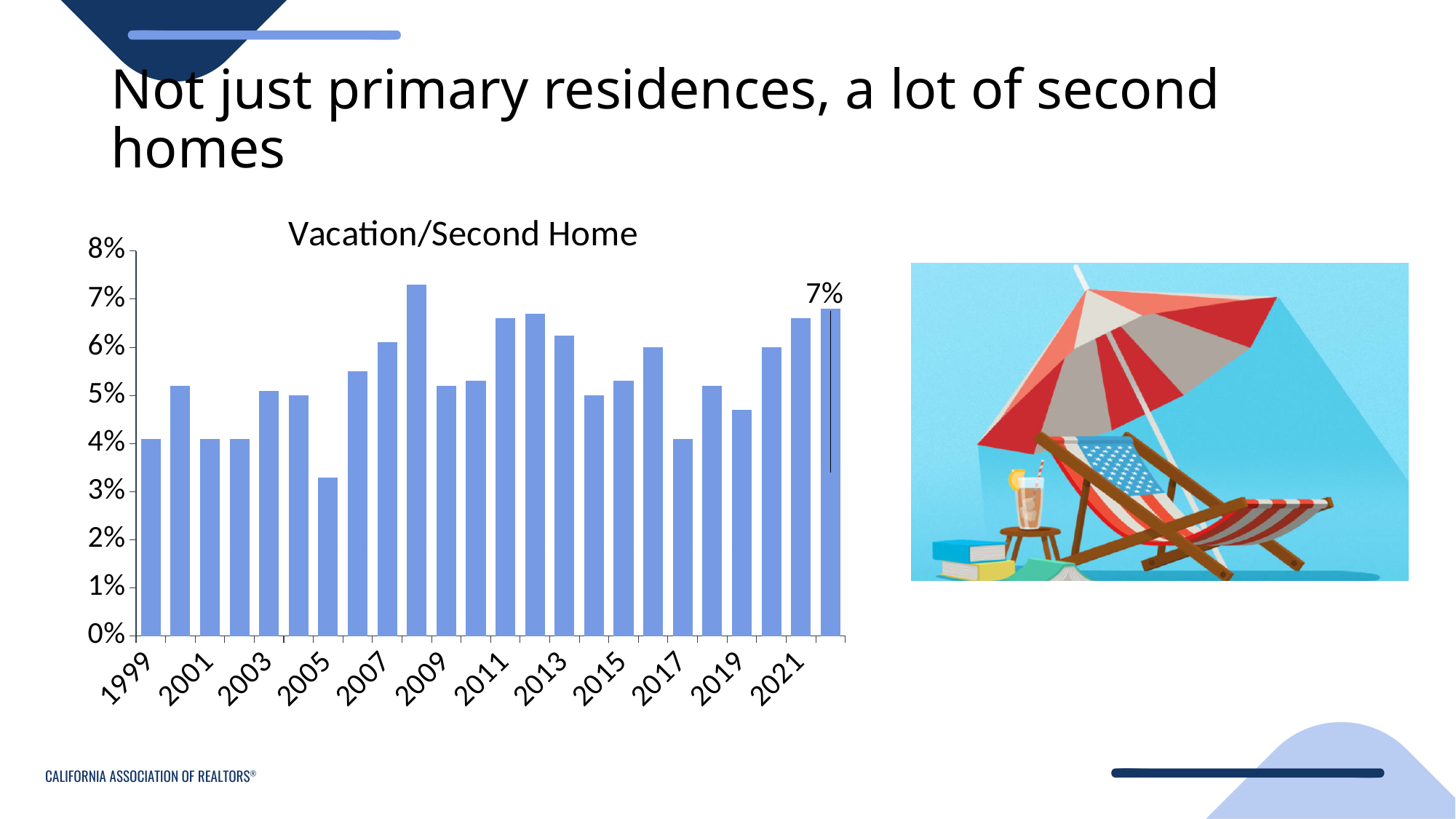
Is the value for 2019 greater or less than 5%? less Is the value for 2021 greater or less than 6%? greater Is the value for 2005 greater or less than 4%? less Which year has the larger value, 2007 or 2005? 2007 What type of chart is shown on the slide? bar chart Which year has the lowest bar in the chart? 2005 Between 2005 and 2007, do the values rise or fall? rise Which year has the larger value, 2011 or 2019? 2011 What is the title of the chart? Vacation/Second Home What value is printed as a data label on the rightmost bar of the chart? 7% How many bars are plotted in the chart? 24